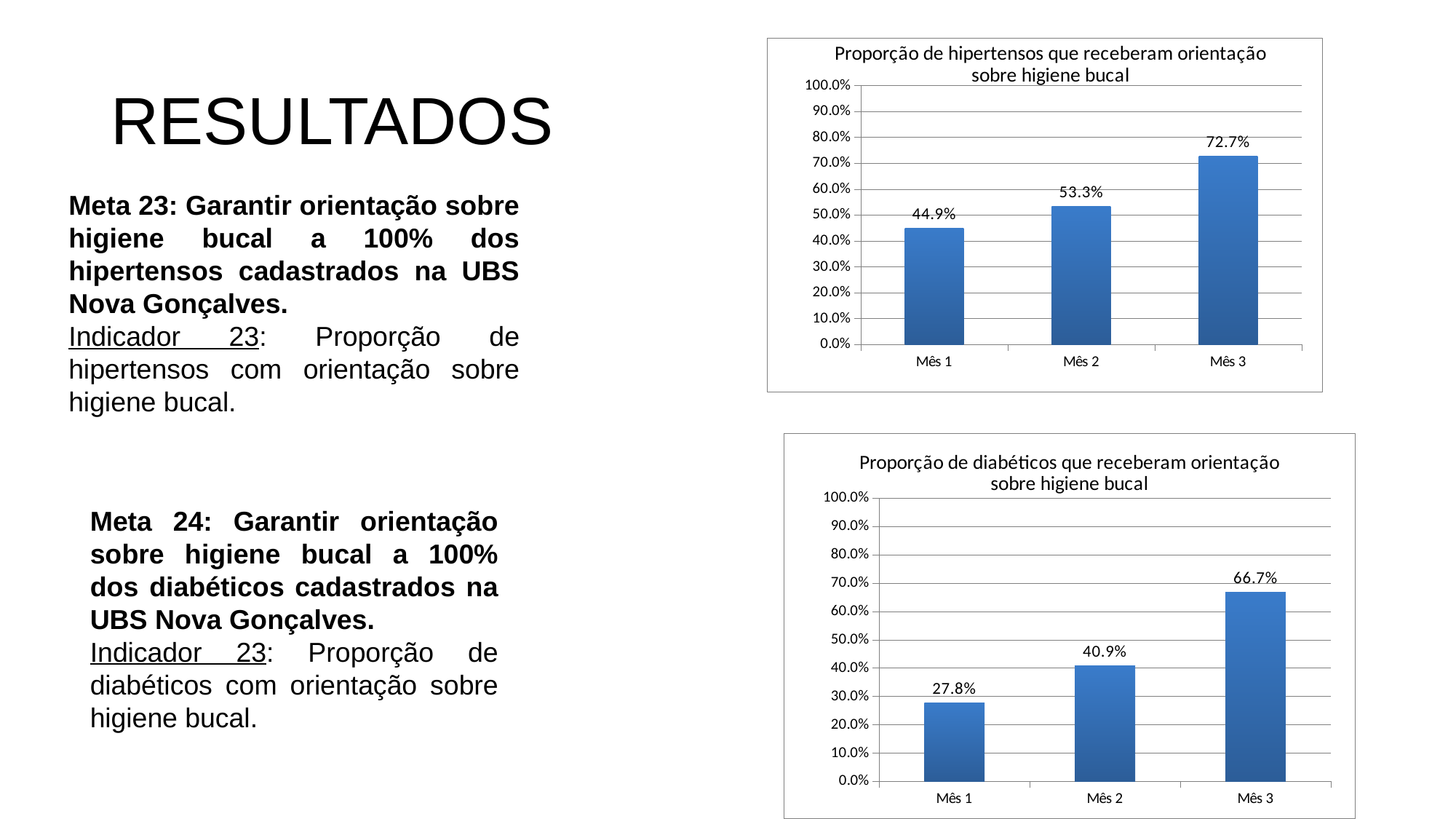
In the chart 'Proporção de diabéticos que receberam orientação sobre higiene bucal', what is the difference between Mês 3 and Mês 2? 25.8% In the chart 'Proporção de diabéticos que receberam orientação sobre higiene bucal', is the value for Mês 3 greater or less than 60.0%? greater In the chart 'Proporção de diabéticos que receberam orientação sobre higiene bucal', what is the value for Mês 1? 27.8% In the chart 'Proporção de hipertensos que receberam orientação sobre higiene bucal', what is the value for Mês 3? 72.7% In the chart 'Proporção de diabéticos que receberam orientação sobre higiene bucal', what is the value for Mês 2? 40.9% How many categories are shown on the x axis of the chart 'Proporção de hipertensos que receberam orientação sobre higiene bucal'? 3 In the chart 'Proporção de hipertensos que receberam orientação sobre higiene bucal', which month has the highest value? Mês 3 In the chart 'Proporção de diabéticos que receberam orientação sobre higiene bucal', which month has the lowest value? Mês 1 In the chart 'Proporção de hipertensos que receberam orientação sobre higiene bucal', what is the value for Mês 1? 44.9% In the chart 'Proporção de hipertensos que receberam orientação sobre higiene bucal', what is the difference between Mês 3 and Mês 1? 27.8% Which is larger: the Mês 2 value in the hipertensos chart or the Mês 2 value in the diabéticos chart? The hipertensos chart (53.3%) What kind of chart is 'Proporção de diabéticos que receberam orientação sobre higiene bucal'? Bar chart